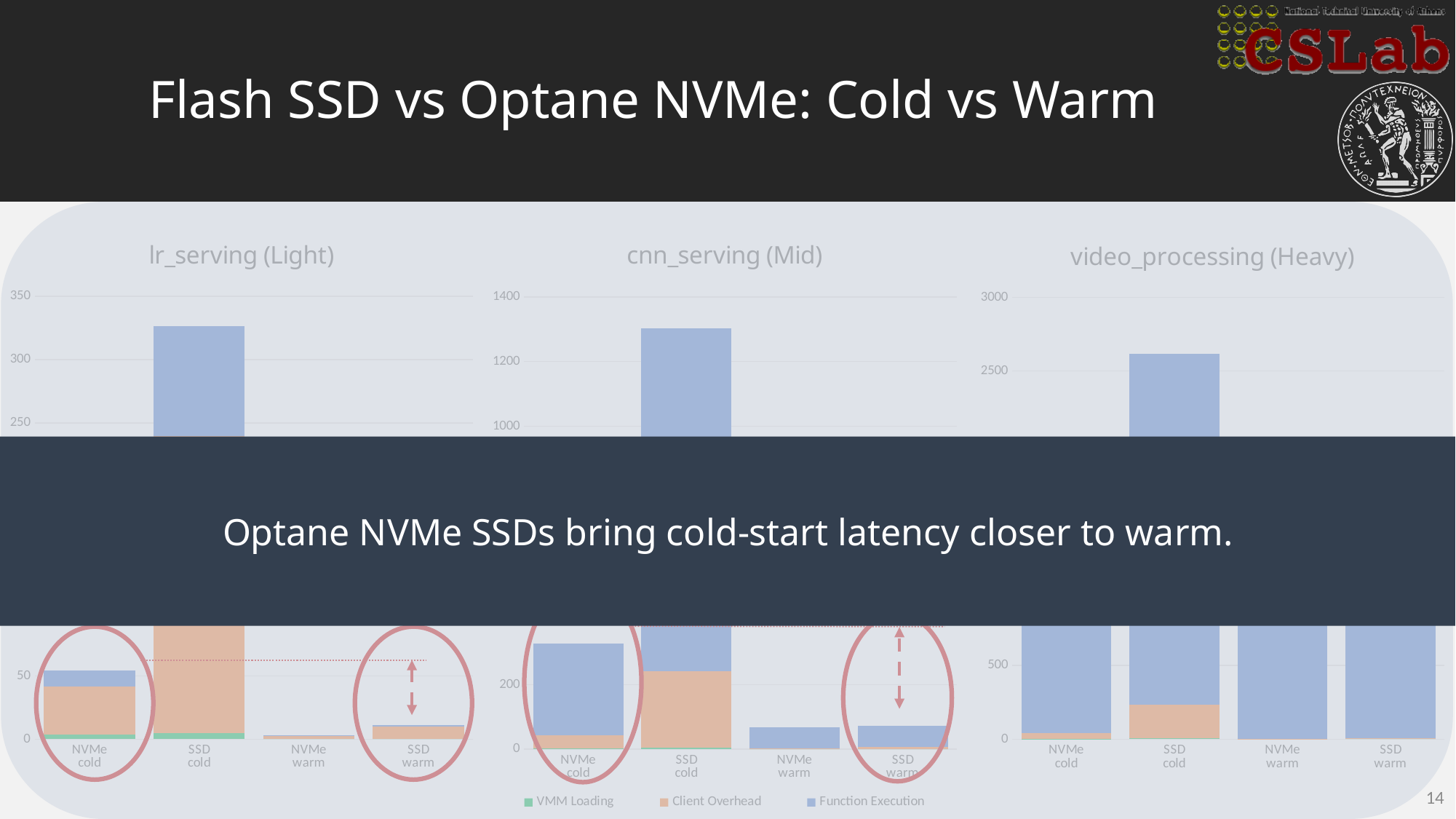
In the lr_serving (Light) chart, which category has the lowest total? NVMe warm How many categories are shown on the x axis of the cnn_serving (Mid) chart? 4 In the video_processing (Heavy) chart, which category has the highest total? SSD cold What kind of chart is the lr_serving (Light) chart? stacked bar chart How many series does the legend list? 3 In the cnn_serving (Mid) chart, which is larger, the total for NVMe cold or SSD cold? SSD cold In the cnn_serving (Mid) chart, is the total for NVMe cold greater or less than 200? greater In the lr_serving (Light) chart, is the total for SSD warm greater or less than 50? less In the lr_serving (Light) chart, which category has the highest total? SSD cold In the video_processing (Heavy) chart, is the total for SSD cold greater or less than 2500? greater Which series are listed in the legend? VMM Loading, Client Overhead, Function Execution